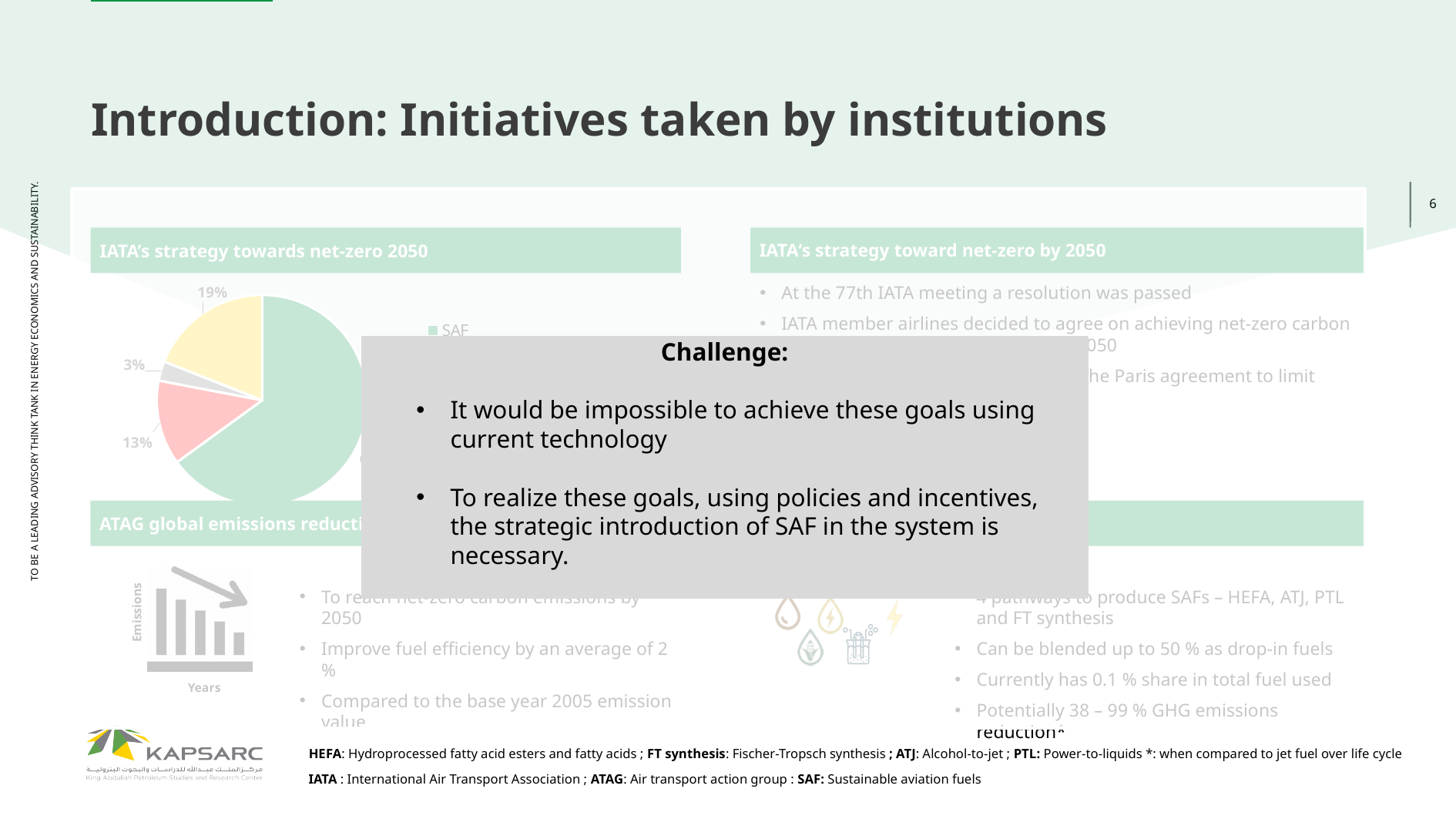
What is the heading above the pie chart? IATA's strategy towards net-zero 2050 Is the value of the grey slice in the pie chart greater or less than 10%? less In the pie chart, what value is labelled on the grey slice? 3% In the pie chart, what value is labelled on the yellow slice? 19% In the pie chart, which of the labelled slices has the smallest value? The grey slice (3%) In the pie chart, what value is labelled on the red slice? 13% What kind of chart is shown under the heading "IATA's strategy towards net-zero 2050"? Pie chart In the pie chart, what is the difference between the yellow slice (19%) and the red slice (13%)? 6 percentage points In the pie chart, which colour slice is the largest? The green slice What is the first legend entry shown next to the pie chart? SAF In the pie chart, which is larger: the yellow slice or the red slice? The yellow slice